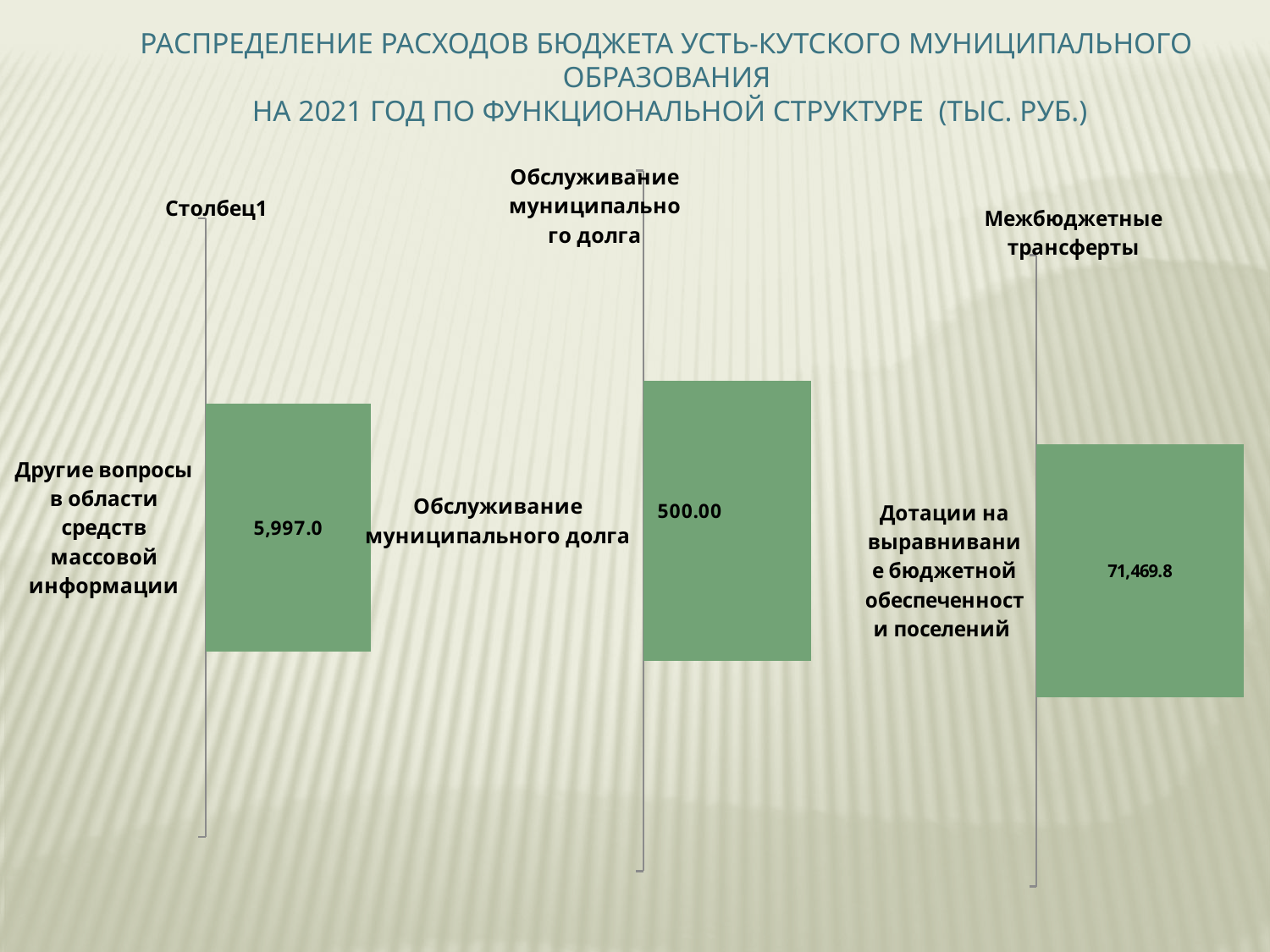
What is the category label of the bar on the right chart titled 'Межбюджетные трансферты'? Дотации на выравнивание бюджетной обеспеченности поселений On the right chart titled 'Межбюджетные трансферты', what is the value for 'Дотации на выравнивание бюджетной обеспеченности поселений'? 71,469.8 Across the three charts on the slide, which chart shows the lowest value? Обслуживание муниципального долга How many bars does the middle chart titled 'Обслуживание муниципального долга' contain? 1 Which is larger: the value on the left chart 'Столбец1' (5,997.0) or the value on the middle chart 'Обслуживание муниципального долга' (500.00)? Столбец1 (5,997.0) Across the three charts on the slide, which chart shows the highest value? Межбюджетные трансферты What is the difference between the value on the right chart 'Межбюджетные трансферты' and the value on the left chart 'Столбец1'? 65,472.8 On the middle chart titled 'Обслуживание муниципального долга', what is the value shown on the bar? 500.00 How many bars does the right chart titled 'Межбюджетные трансферты' contain? 1 What is the difference between the value on the left chart 'Столбец1' and the value on the middle chart 'Обслуживание муниципального долга'? 5,497.0 On the left chart titled 'Столбец1', what is the value for 'Другие вопросы в области средств массовой информации'? 5,997.0 What kind of chart is the left chart titled 'Столбец1'? Bar chart